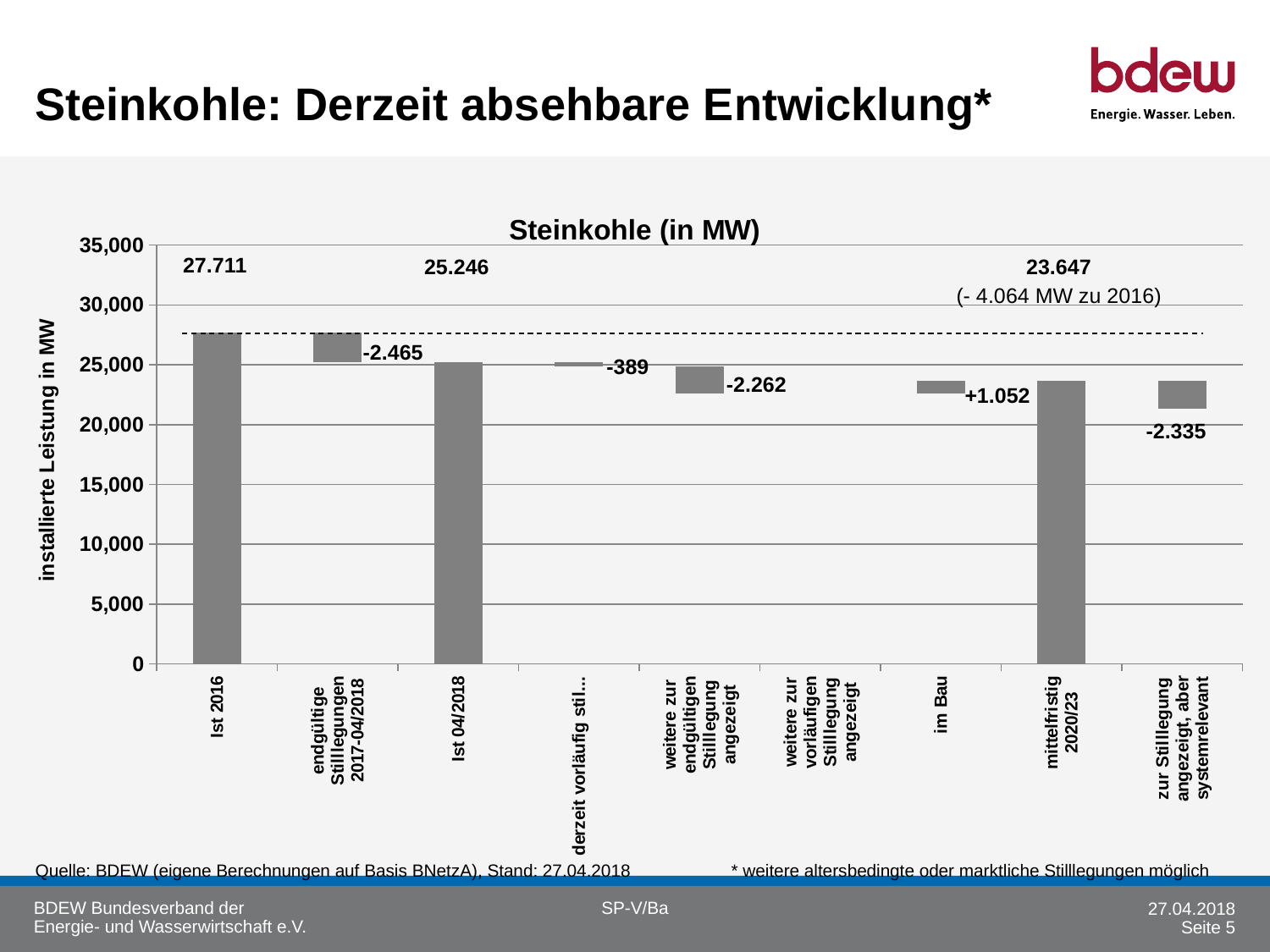
Which is larger, the value for Ist 2016 or the value for Ist 04/2018? Ist 2016 What is the value labelled for zur Stilllegung angezeigt, aber systemrelevant? -2.335 What is the value labelled for im Bau? +1.052 What is the value for Ist 04/2018? 25.246 Is the value for Ist 2016 greater or less than 25,000? greater What is the value for Ist 2016? 27.711 What is the value labelled for endgültige Stilllegungen 2017-04/2018? -2.465 What kind of chart is shown on the slide? bar chart What is the label of the vertical axis? installierte Leistung in MW What is the difference between the value for Ist 2016 and the value for mittelfristig 2020/23? 4.064 What is the value labelled for weitere zur endgültigen Stilllegung angezeigt? -2.262 What is the value for mittelfristig 2020/23? 23.647